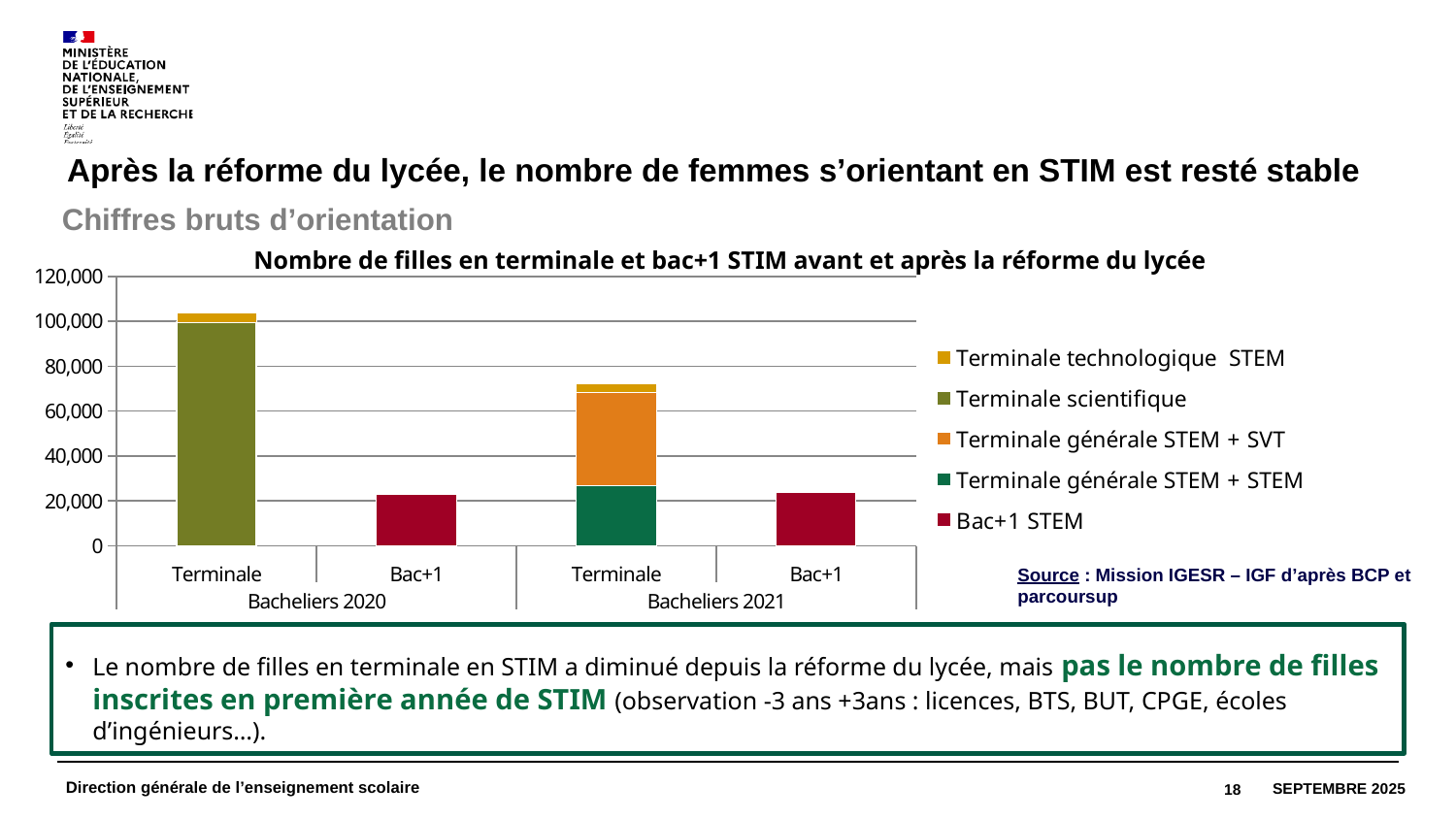
Is the value for Bac+1 (Bacheliers 2020) greater or less than 40,000? less How many bars are plotted in the chart? 4 What is the title of the chart? Nombre de filles en terminale et bac+1 STIM avant et après la réforme du lycée How many series does the chart legend list? 5 Which bar is the tallest in the chart? Terminale, Bacheliers 2020 Which series appears in the Terminale bar for Bacheliers 2021 but not in the Terminale bar for Bacheliers 2020? Terminale générale STEM + SVT and Terminale générale STEM + STEM What kind of chart is shown on the slide? Stacked bar chart Which is larger: the Terminale bar for Bacheliers 2020 or the Terminale bar for Bacheliers 2021? Terminale, Bacheliers 2020 Is the Terminale générale STEM + STEM segment for Bacheliers 2021 greater or less than 20,000? greater Is the Terminale scientifique segment for Bacheliers 2020 greater or less than 80,000? greater